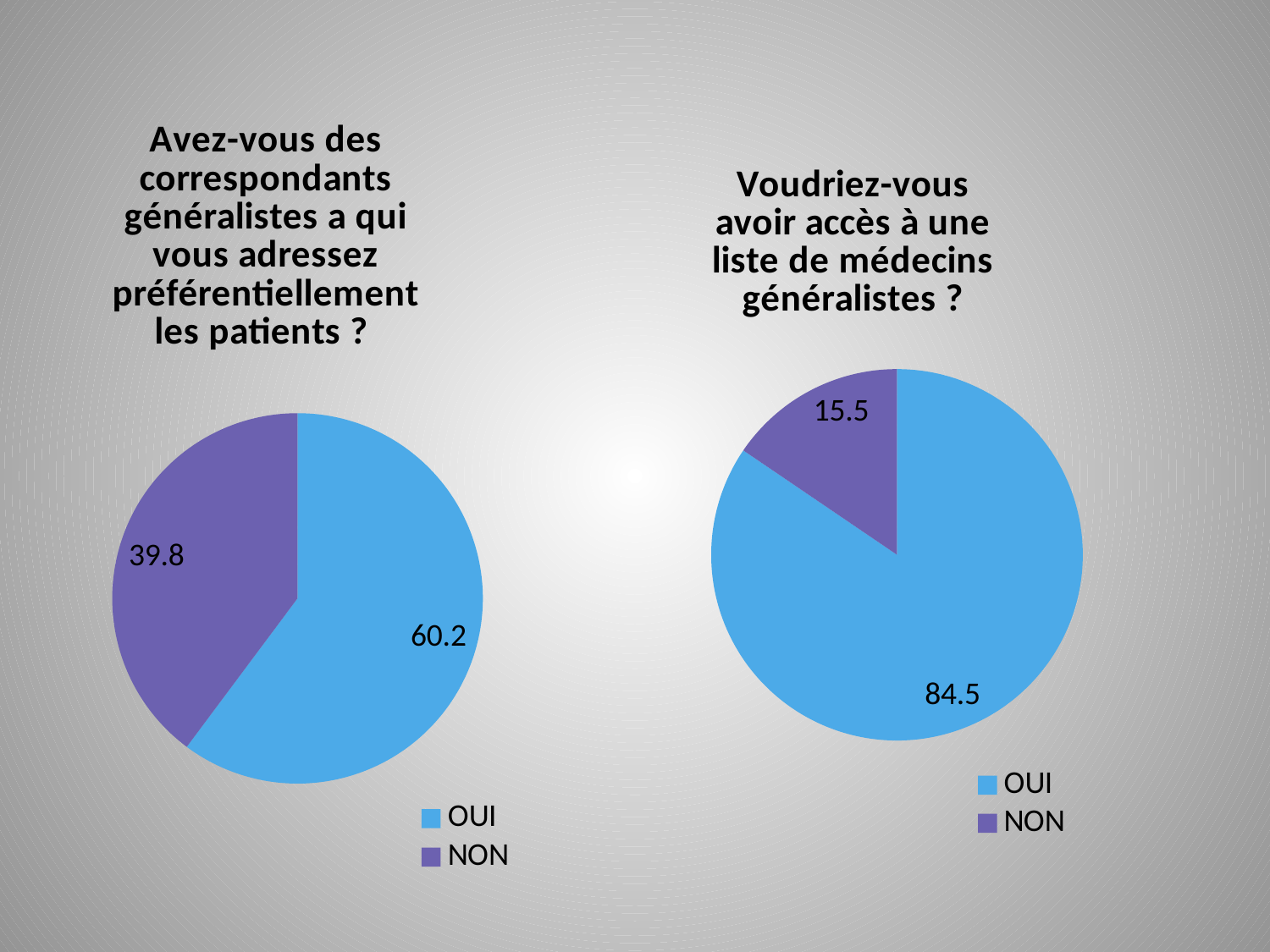
In the left pie chart ("Avez-vous des correspondants généralistes..."), what is the value for NON? 39.8 In the right pie chart ("Voudriez-vous avoir accès à une liste de médecins généralistes ?"), what is the value for OUI? 84.5 How many slices does the right pie chart have? 2 What type of chart is used on the left of the slide? pie chart In the left pie chart, which colour represents NON? purple In the right pie chart, which category has the smallest slice? NON In the left pie chart, which category has the largest slice? OUI In the right pie chart, what is the difference between the OUI and NON values? 69 Is the OUI value larger in the left pie chart or in the right pie chart? right pie chart In the right pie chart ("Voudriez-vous avoir accès à une liste de médecins généralistes ?"), what is the value for NON? 15.5 In the left pie chart ("Avez-vous des correspondants généralistes..."), what is the value for OUI? 60.2 In the left pie chart, what is the difference between the OUI and NON values? 20.4